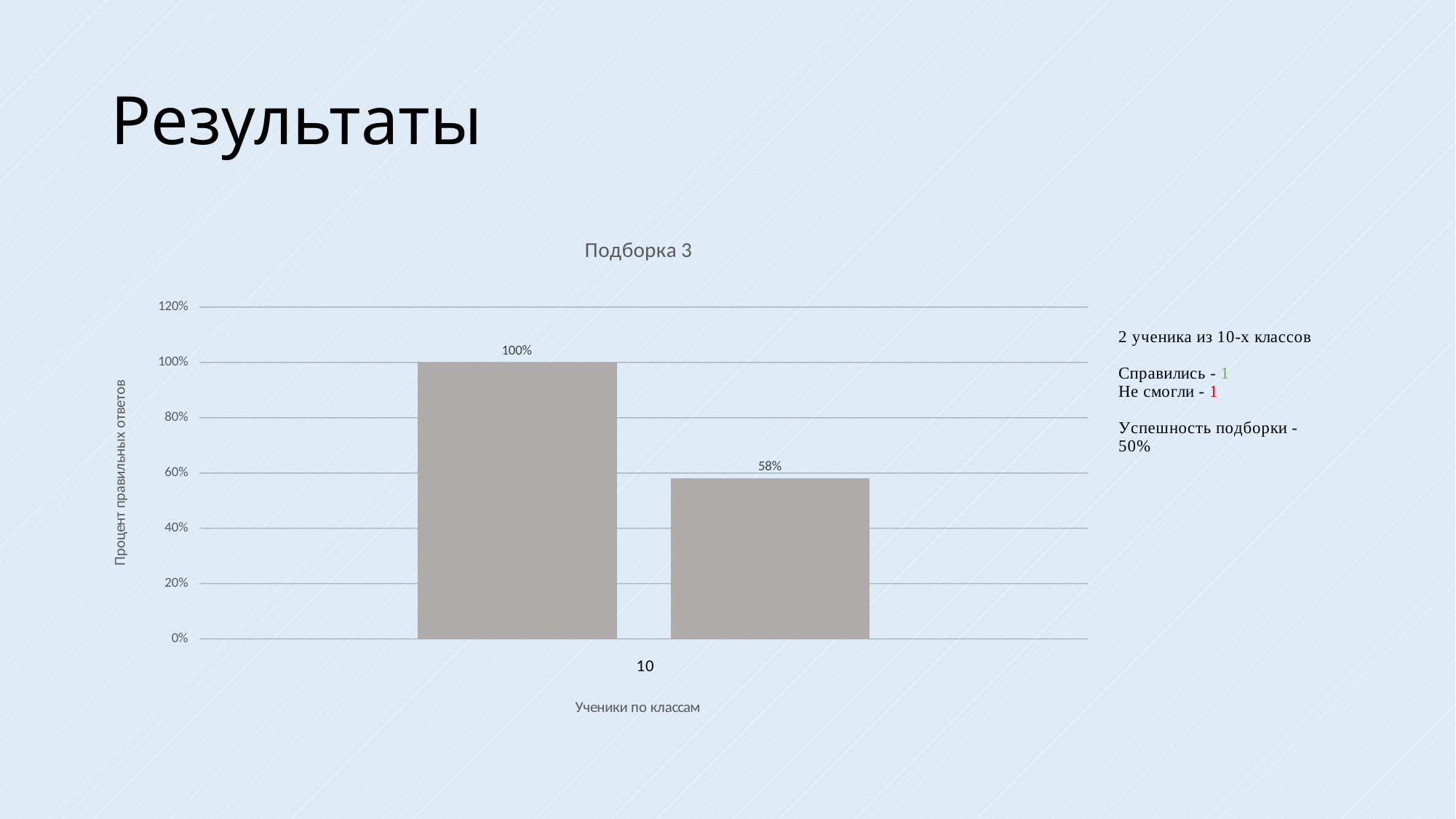
What is the title of the chart? Подборка 3 Do the values fall or rise from the left bar to the right bar? fall What is the lowest value shown in the chart? 58% What category label is shown on the x axis? 10 What is the difference between the left bar and the right bar? 42% Is the value of the right bar greater or less than 60%? less How many bars are plotted in the chart? 2 Which bar is taller, the left one or the right one? the left one What is the value of the left bar in the chart? 100% What is the highest value shown in the chart? 100% What type of chart is shown on the slide? bar chart What is the value of the right bar in the chart? 58%